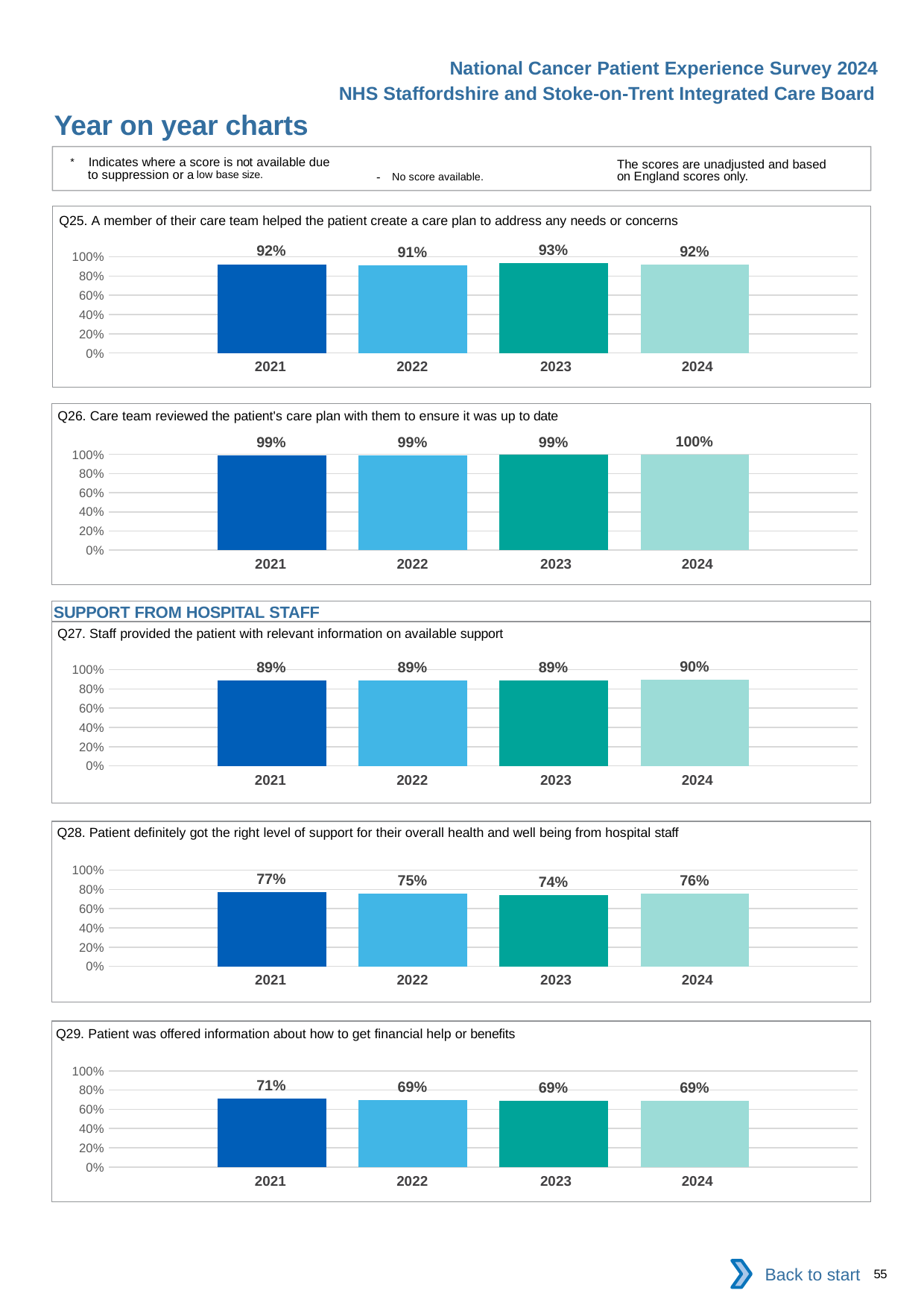
In the Q29 chart (information about financial help or benefits), what is the value for 2021? 71% In the Q27 chart (staff provided information on available support), which year has the highest value? 2024 In the Q25 chart (care team helped create a care plan), what is the value for 2023? 93% In the Q26 chart (care team reviewed the care plan), what is the value for 2024? 100% In the Q26 chart (care team reviewed the care plan), how many years are plotted? 4 In the Q25 chart (care team helped create a care plan), which year has the lowest value? 2022 In the Q28 chart (right level of support from hospital staff), which is larger, the value for 2022 or the value for 2024? 2024 In the Q27 chart (staff provided information on available support), what is the value for 2021? 89% In the Q28 chart (right level of support from hospital staff), what is the difference between the 2021 and 2023 values? 3 percentage points What kind of chart is the Q25 chart? Bar chart In the Q29 chart (information about financial help or benefits), is the value for 2024 greater or less than 80%? less In the Q28 chart (right level of support from hospital staff), which year has the lowest value? 2023